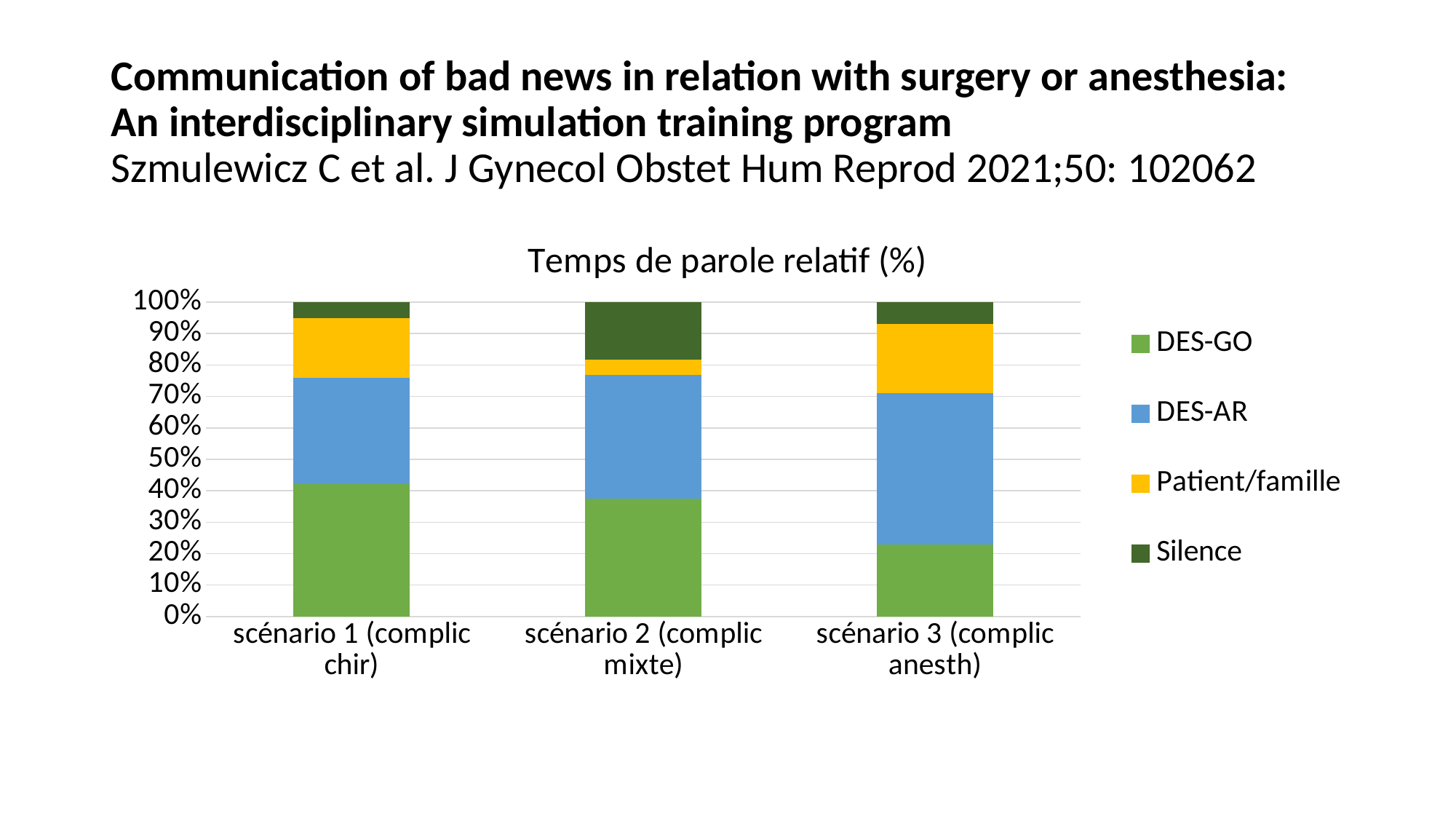
Which colour represents the Silence series in the chart? Dark green Which scenario has the largest Silence share? scénario 2 (complic mixte) Is the DES-GO share for scénario 3 (complic anesth) greater or less than 30%? less How many scenarios (categories) are shown on the x axis of the chart? 3 What is the title of the chart? Temps de parole relatif (%) Which scenario has the smallest DES-GO share of speaking time? scénario 3 (complic anesth) How many series does the chart legend list? 4 What kind of chart is shown on the slide? Stacked bar chart Does the DES-GO share rise or fall from scénario 1 to scénario 3 along the x axis? Falls Is the DES-AR share larger in scénario 3 (complic anesth) or in scénario 1 (complic chir)? scénario 3 (complic anesth) Which scenario has the largest DES-GO share of speaking time? scénario 1 (complic chir) Which scenario has the smallest Patient/famille share? scénario 2 (complic mixte)